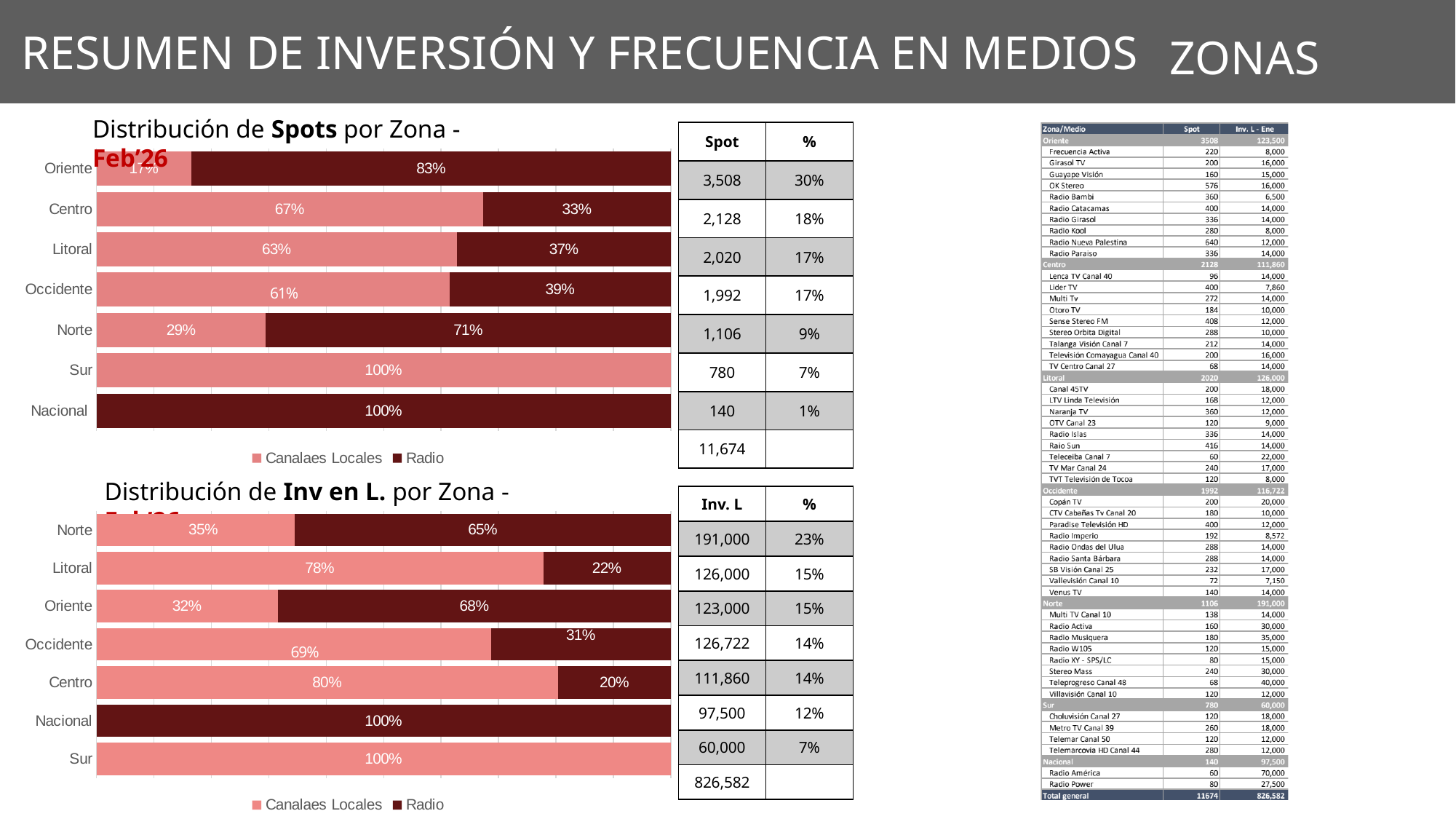
In the 'Distribución de Inv en L. por Zona' chart, what is the Radio share for Oriente? 68% In the 'Distribución de Spots por Zona' chart, what is the Radio share for Norte? 71% In the 'Distribución de Inv en L. por Zona' chart, which zone has the lowest Radio share among zones with both series? Centro In the 'Distribución de Inv en L. por Zona' chart, which is larger for Occidente: Canalaes Locales or Radio? Canalaes Locales In the 'Distribución de Spots por Zona' chart, what percentage of spots in Oriente are Radio? 83% In the 'Distribución de Inv en L. por Zona' chart, what is the Canalaes Locales share for Centro? 80% In the 'Distribución de Spots por Zona' chart, what is the Canalaes Locales share for Centro? 67% How many series does the legend of the 'Distribución de Inv en L. por Zona' chart list? 2 In the 'Distribución de Spots por Zona' chart, how many zones are shown? 7 In the 'Distribución de Spots por Zona' chart, what is the difference between the Radio and Canalaes Locales shares for Litoral? 26% In the 'Distribución de Spots por Zona' chart, which zone has the highest Canalaes Locales share? Sur What type of chart is the 'Distribución de Spots por Zona' chart? Stacked bar chart